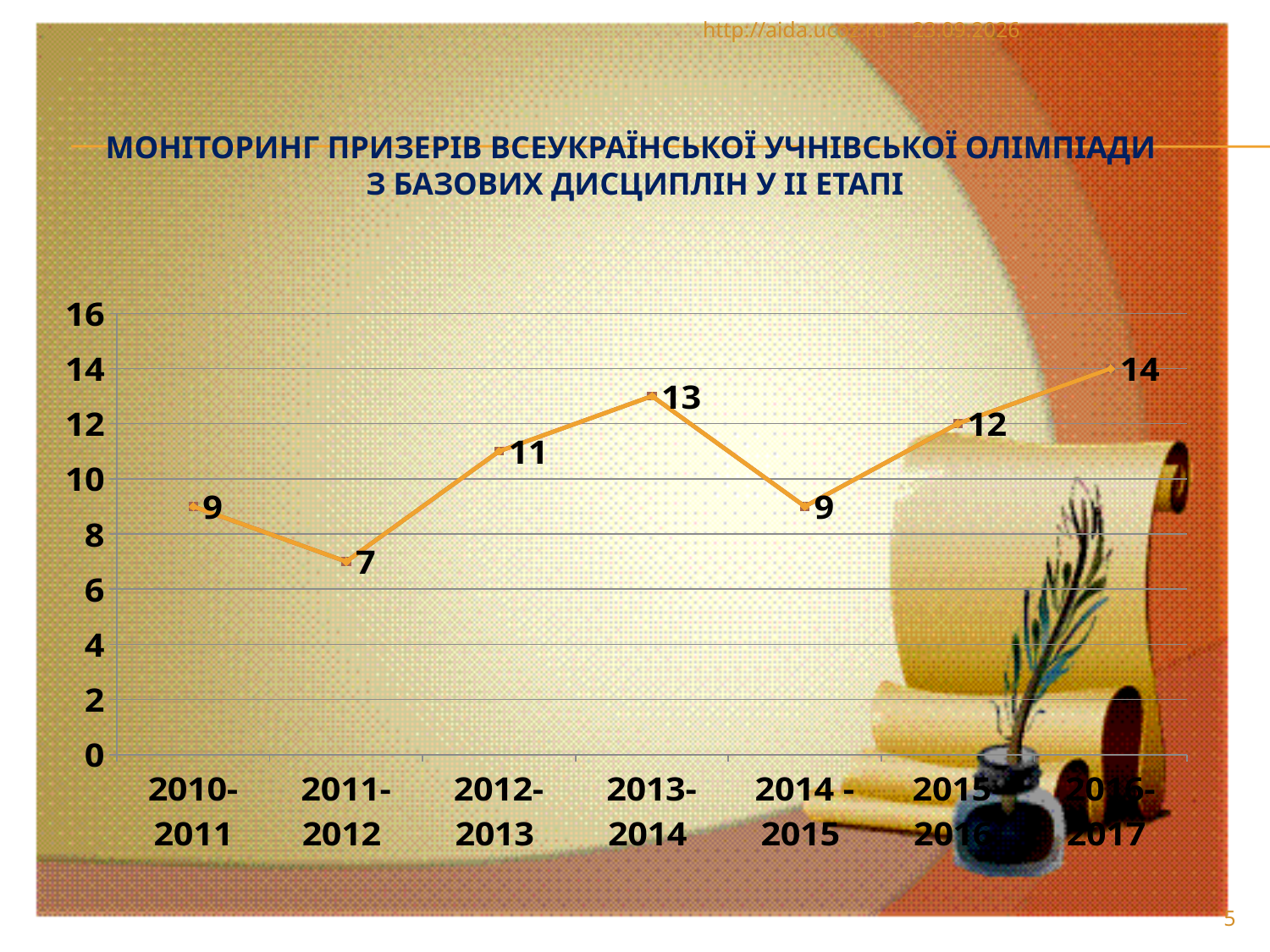
What is the value for 2016-2017? 14 Which is larger, the value for 2012-2013 or the value for 2015-2016? 2015-2016 How many periods are plotted on the chart? 7 What is the difference between the values for 2016-2017 and 2011-2012? 7 What is the value for 2011-2012? 7 What kind of chart is shown on the slide? line chart What is the value for 2013-2014? 13 What is the value for 2015-2016? 12 What is the difference between the values for 2013-2014 and 2014-2015? 4 Which period has the lowest value? 2011-2012 Does the value rise or fall from 2014-2015 to 2016-2017? rise Which period has the highest value? 2016-2017